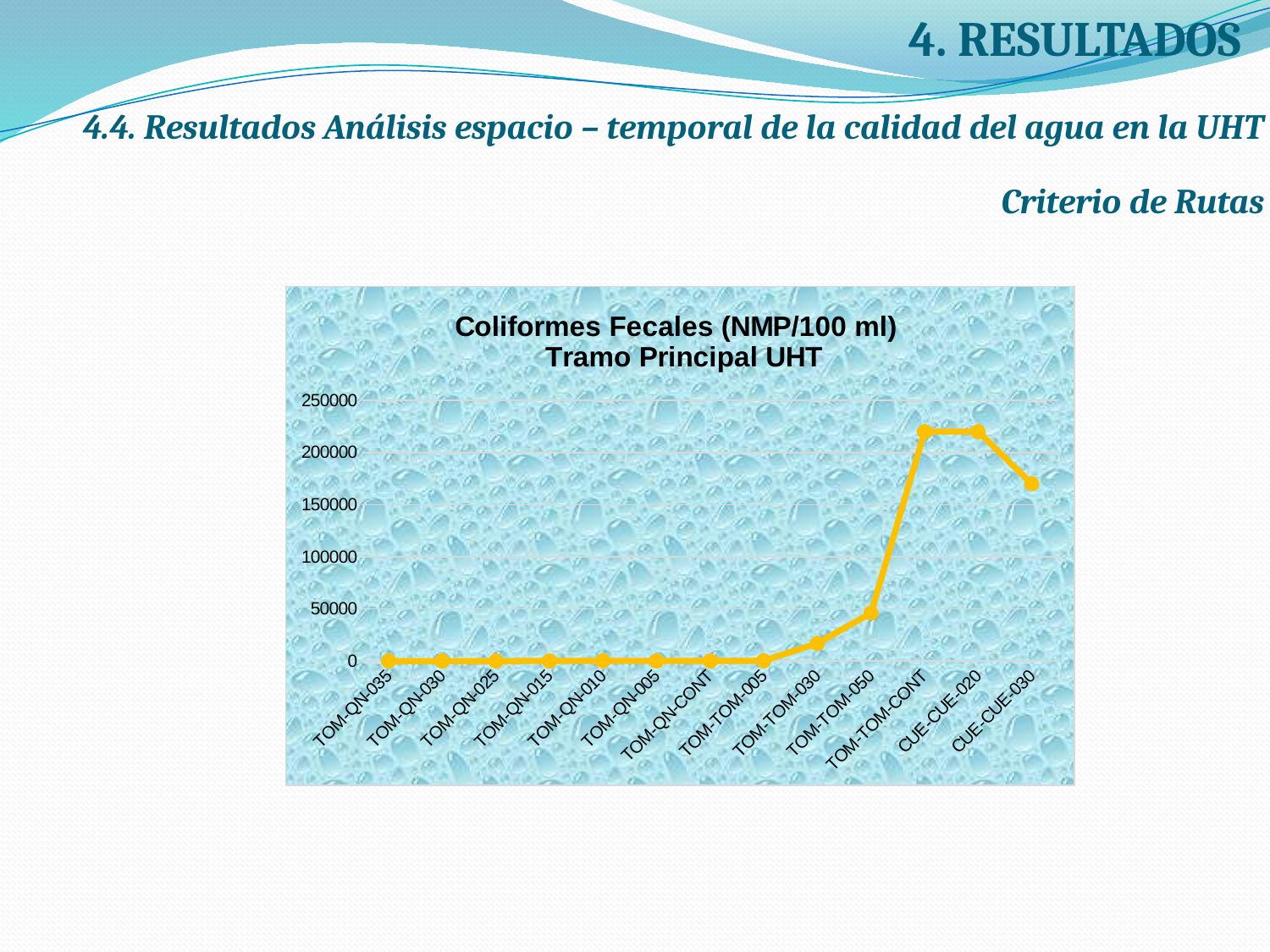
Is the value for TOM-TOM-CONT greater or less than 200000? greater Is the value for CUE-CUE-030 greater or less than 150000? greater How many sampling points are plotted along the x axis? 13 Is the value for TOM-TOM-030 greater or less than 50000? less Which has the higher value, TOM-TOM-CONT or TOM-TOM-050? TOM-TOM-CONT Which has the higher value, TOM-TOM-050 or TOM-TOM-030? TOM-TOM-050 What kind of chart is shown on the slide? line chart What is the title of the chart? Coliformes Fecales (NMP/100 ml) Tramo Principal UHT Which has the higher value, CUE-CUE-020 or CUE-CUE-030? CUE-CUE-020 Do the values generally rise or fall from TOM-QN-035 to CUE-CUE-020 along the x axis? rise